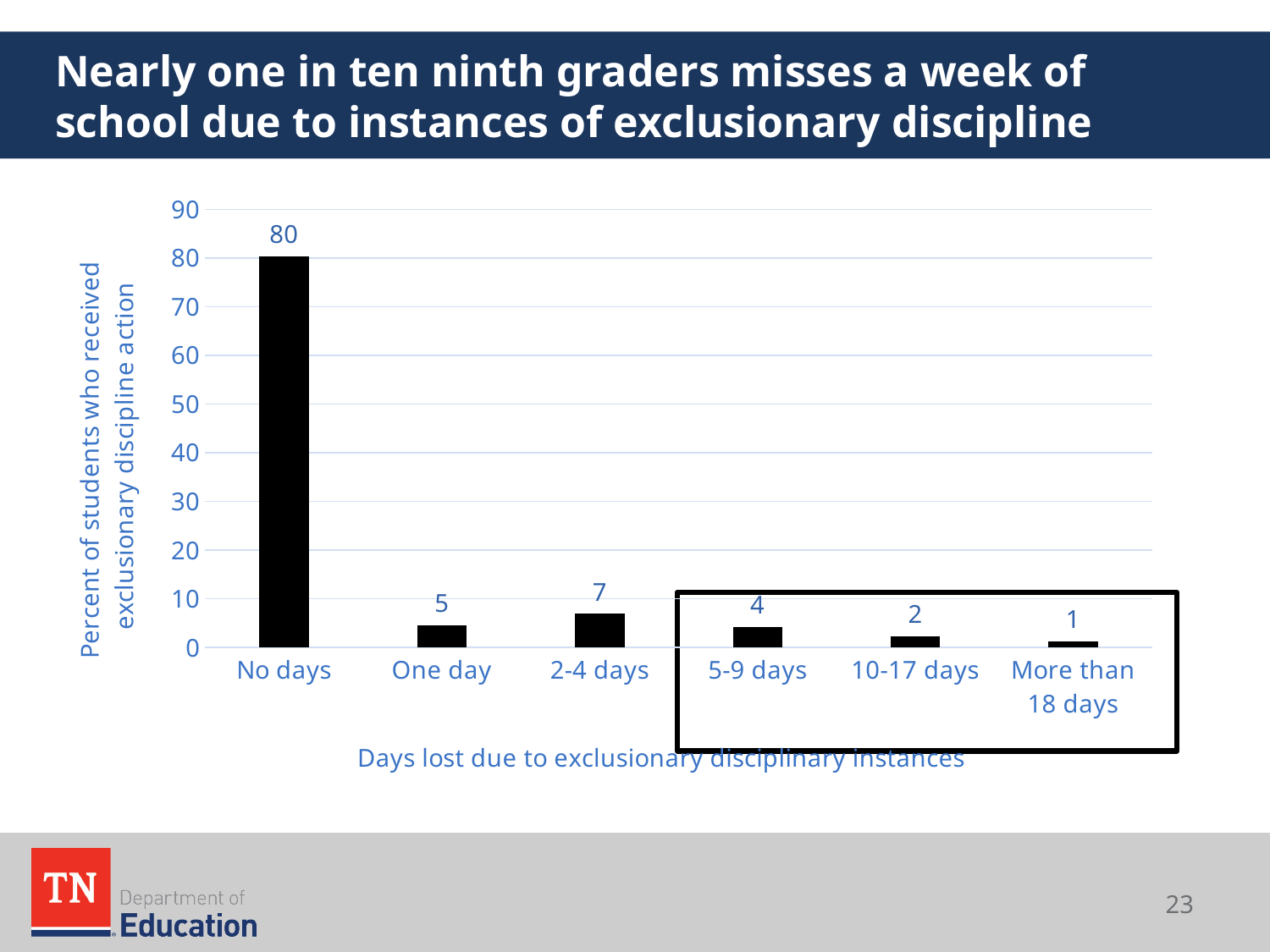
What is the difference between the values for "No days" and "One day"? 75 Which is larger, the value for "One day" or the value for "2-4 days"? 2-4 days What is the value for "No days"? 80 How many categories are shown on the x axis? 6 Is the value for "No days" greater or less than 70? greater What is the value for "10-17 days"? 2 Which category has the lowest value? More than 18 days What is the value for "2-4 days"? 7 Which category has the highest value? No days What kind of chart is shown on the slide? bar chart What is the difference between the values for "2-4 days" and "5-9 days"? 3 What is the label of the x axis? Days lost due to exclusionary disciplinary instances